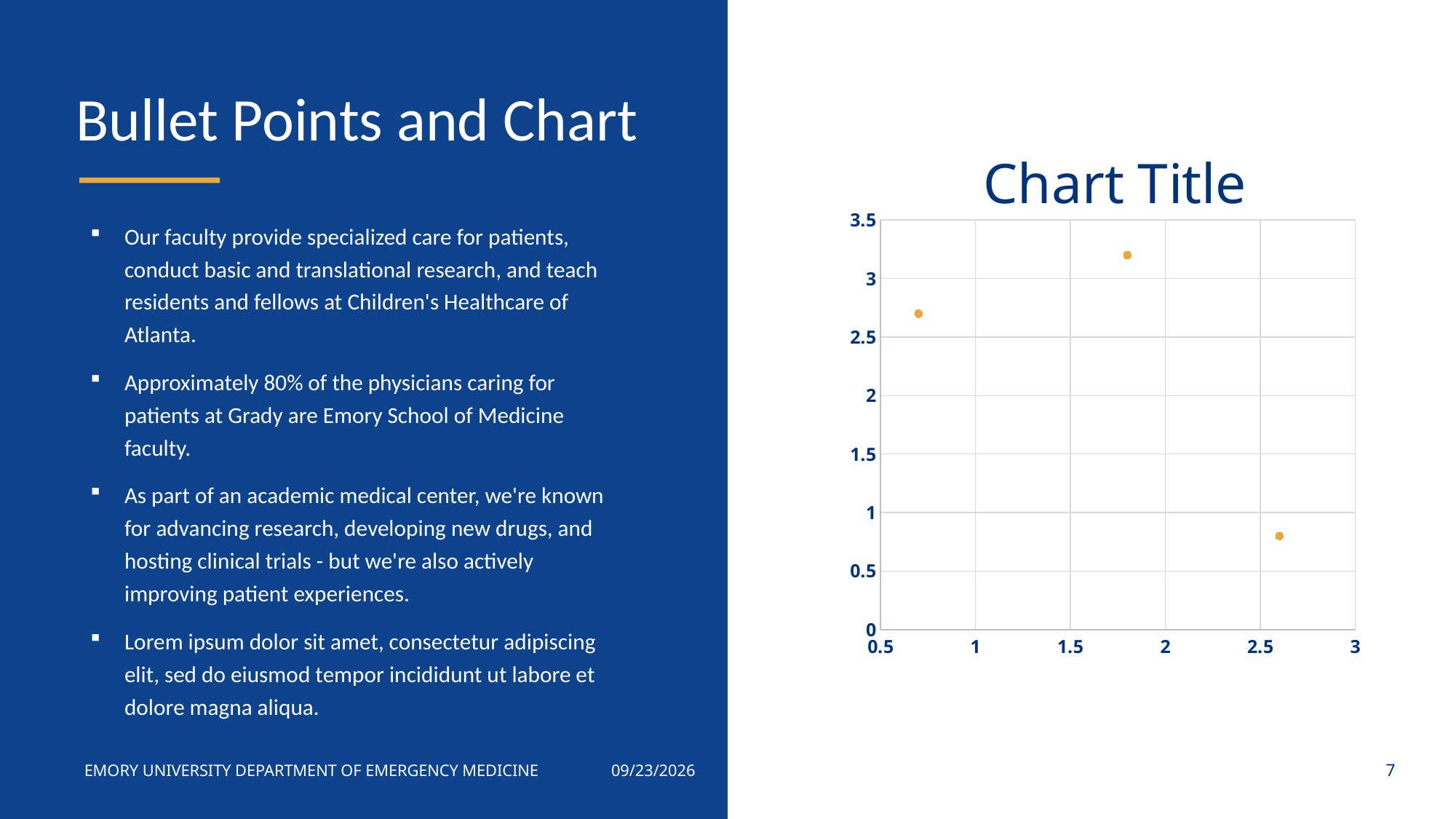
What is the title of the chart? Chart Title Which has the larger y value, the leftmost point or the rightmost point? the leftmost point Which point has the lowest y value: the leftmost, the middle, or the rightmost point? the rightmost point What kind of chart is shown on the slide? scatter chart Is the y value of the leftmost point (near x = 0.5) greater or less than 2.5? greater How many data points are plotted on the chart? 3 Which point has the highest y value: the leftmost, the middle, or the rightmost point? the middle point What is the maximum value shown on the y axis? 3.5 What colour are the plotted points on the chart? orange Is the y value of the rightmost point (near x = 2.5) greater or less than 1? less Is the y value of the leftmost point (near x = 0.5) greater or less than 3? less